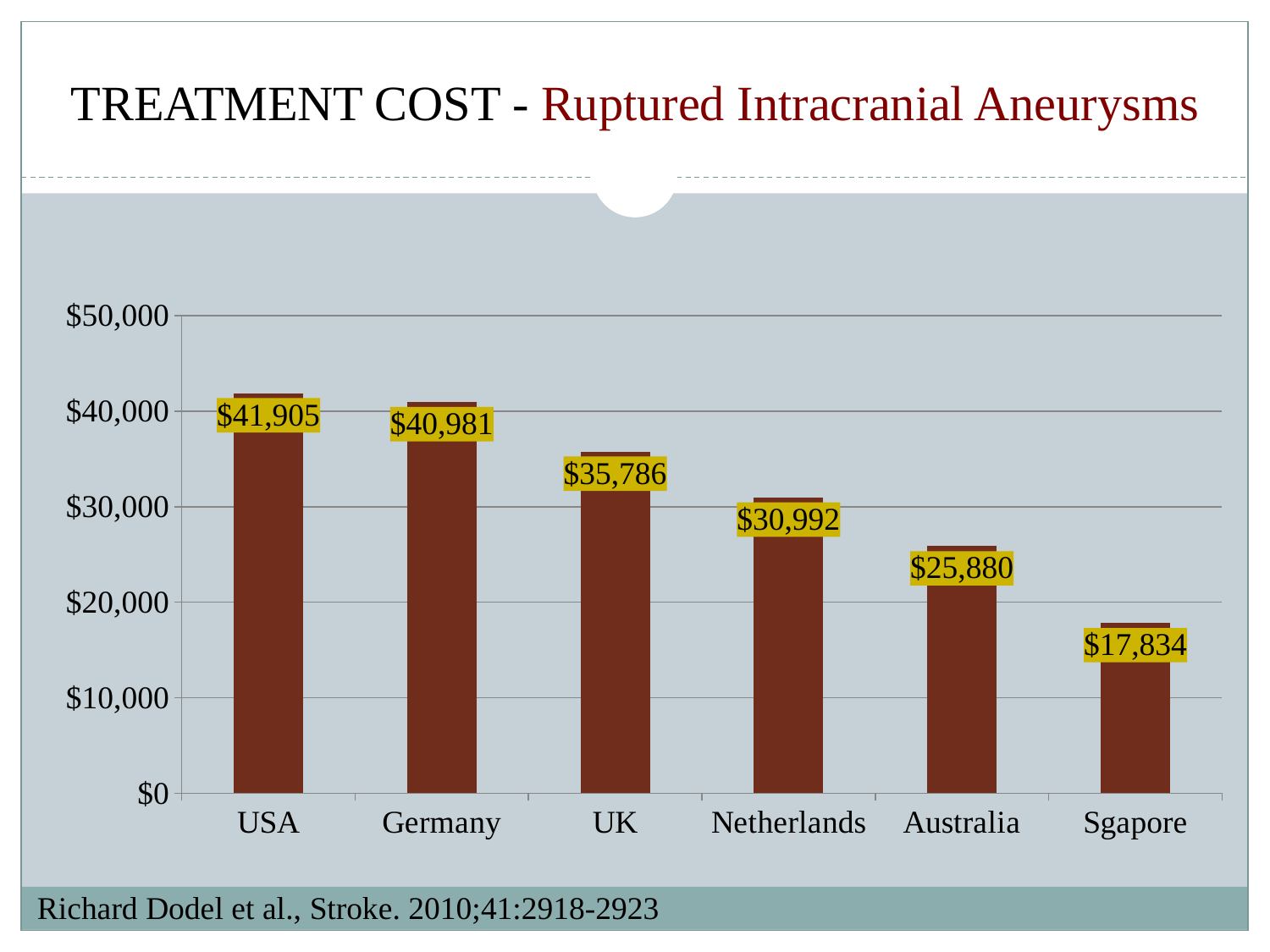
What is the treatment cost shown for the USA? $41,905 Do the values rise or fall from left to right along the x axis? Fall Which has a higher treatment cost, the UK or the Netherlands? UK Which country has the lowest treatment cost? Sgapore What is the difference between the treatment cost for the UK and for Australia? $9,906 How many countries are shown on the chart? 6 What is the treatment cost shown for Sgapore? $17,834 What is the difference between the treatment cost for the USA and for Sgapore? $24,071 What is the treatment cost shown for the Netherlands? $30,992 Is the value for Australia greater or less than $30,000? less Which country has the highest treatment cost? USA What kind of chart is shown on the slide? Bar chart